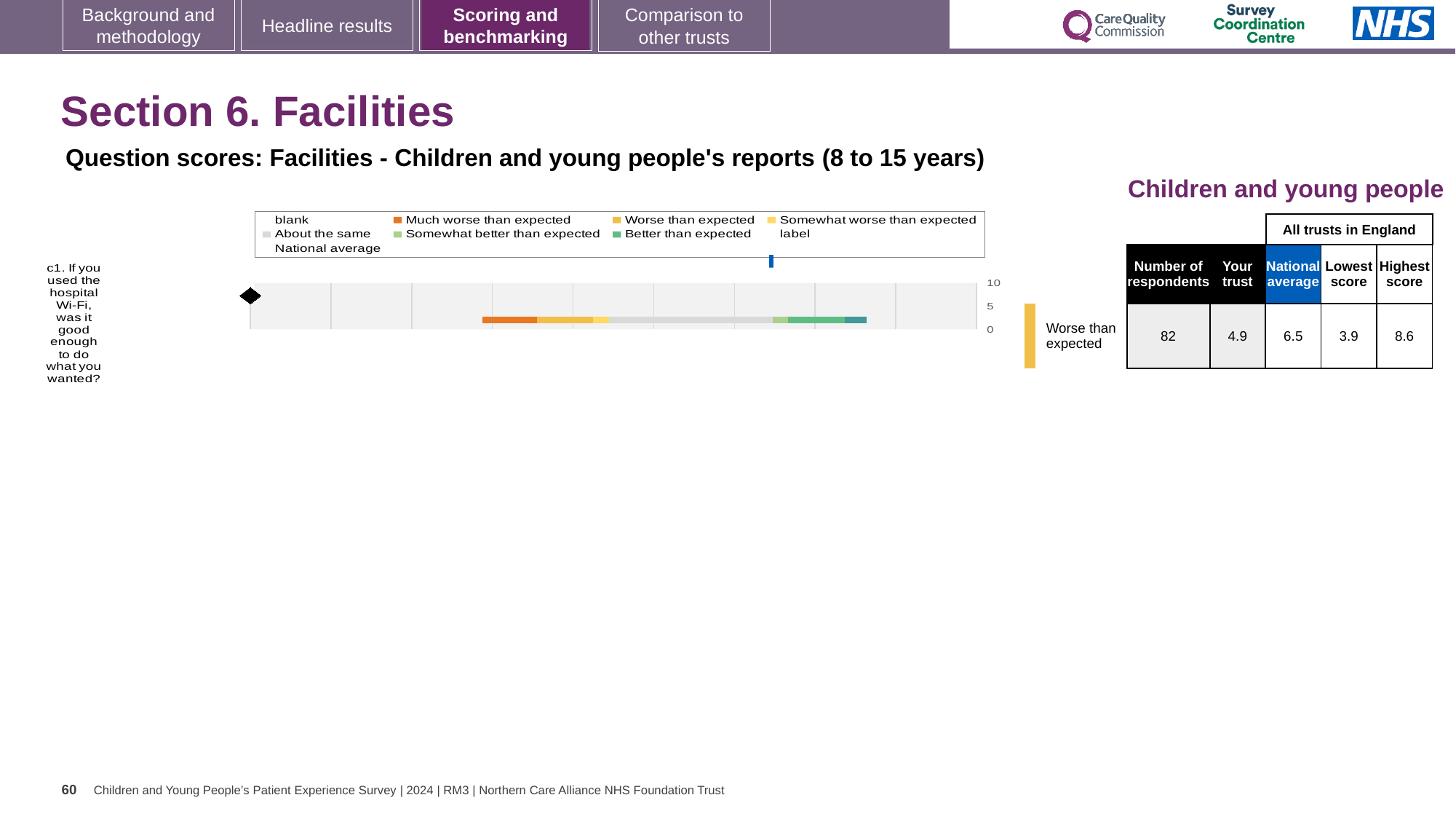
What is the difference between the highest and lowest scores among all trusts in England for question c1? 4.7 What is the 'Your trust' score for question c1? 4.9 What is the benchmark category shown for question c1? Worse than expected What kind of chart is shown on the slide? bar chart What is the lowest score among all trusts in England for question c1? 3.9 How many survey questions are plotted in the chart? 1 What is the difference between the national average and the 'Your trust' score for question c1? 1.6 What is the national average score for question c1? 6.5 Which survey question is plotted in the chart? c1. If you used the hospital Wi-Fi, was it good enough to do what you wanted? What is the number of respondents for question c1? 82 Which is larger for question c1, the 'Your trust' score or the national average? National average What is the highest score among all trusts in England for question c1? 8.6